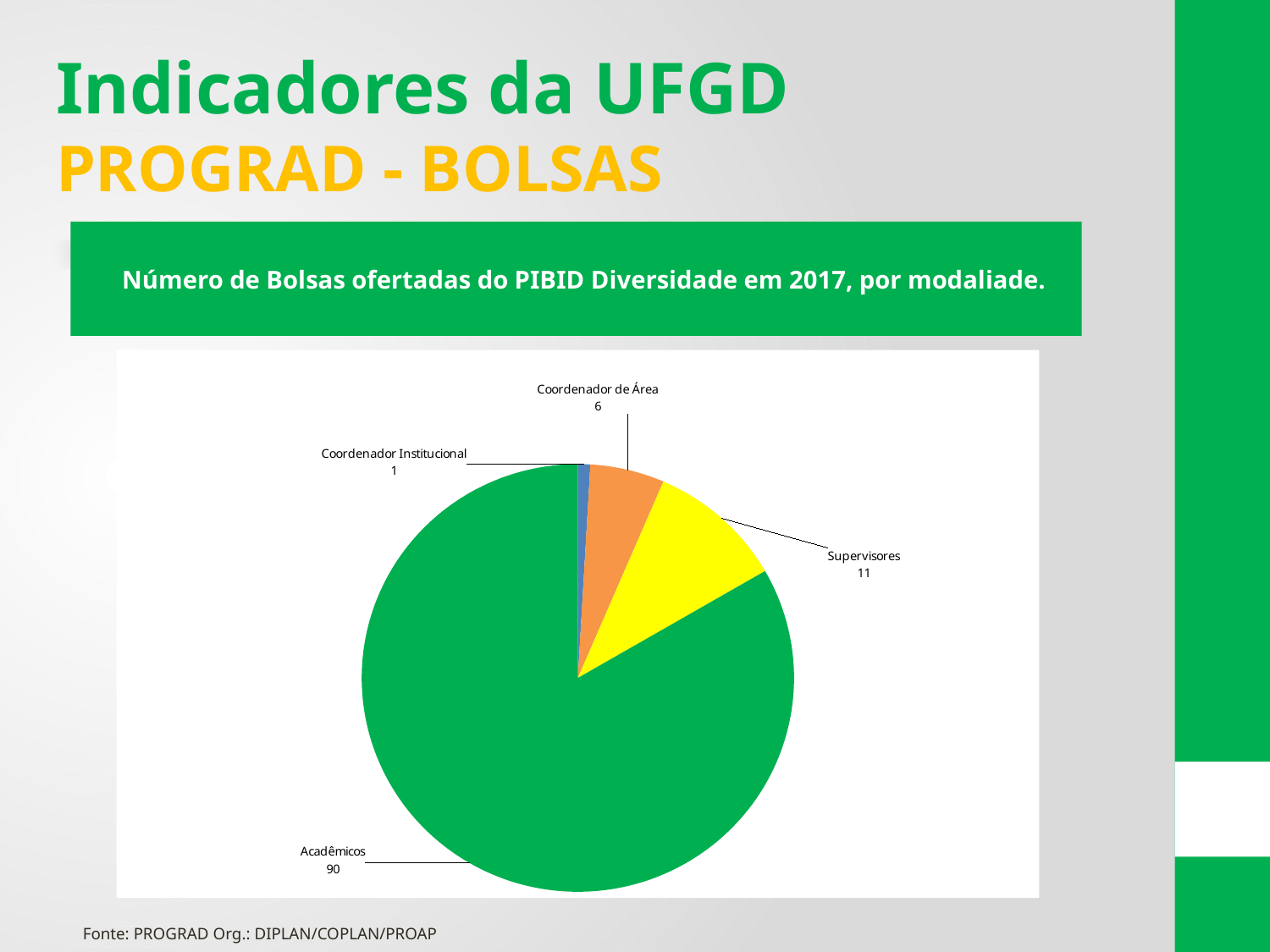
What is the title of the chart shown on the slide? Número de Bolsas ofertadas do PIBID Diversidade em 2017, por modaliade. What is the value for Coordenador de Área? 6 What is the difference between the values for Supervisores and Coordenador de Área? 5 Which is larger, the value for Supervisores or the value for Coordenador de Área? Supervisores What is the value for Acadêmicos? 90 What is the total of all the values shown in the pie chart? 108 Which category has the largest slice of the pie? Acadêmicos What type of chart is shown on the slide? Pie chart What is the value for Supervisores? 11 How many slices does the pie chart have? 4 What is the value for Coordenador Institucional? 1 Which category has the smallest slice of the pie? Coordenador Institucional